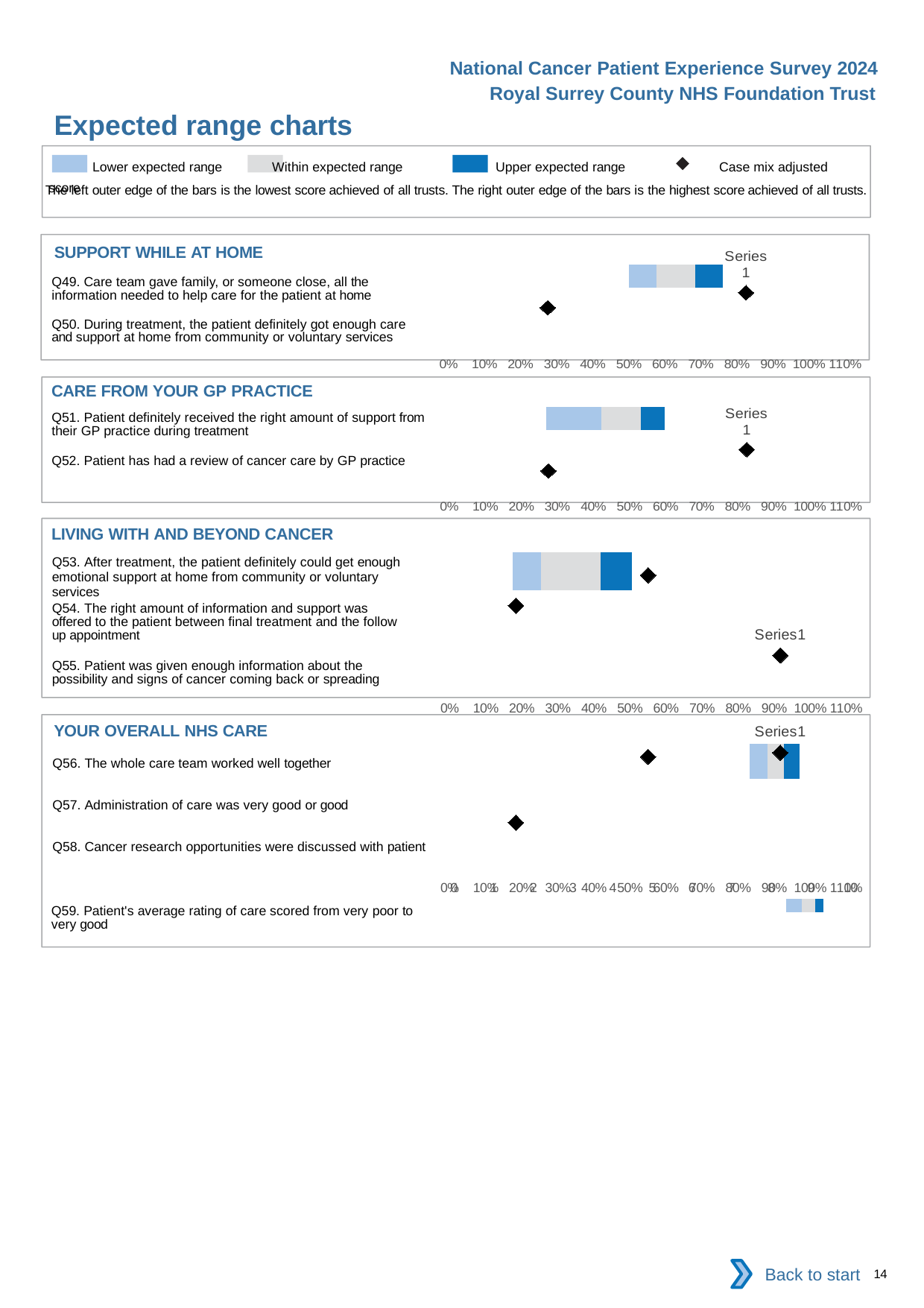
In the SUPPORT WHILE AT HOME chart, which has the higher case mix adjusted score, Q49 or Q50? Q49 What is the title of the slide's charts? Expected range charts In the SUPPORT WHILE AT HOME chart, is the case mix adjusted score for Q49 greater or less than 70%? greater How many questions are plotted in the LIVING WITH AND BEYOND CANCER chart? 3 What is the highest value shown on the x axis of the CARE FROM YOUR GP PRACTICE chart? 110% What kind of chart is used in the SUPPORT WHILE AT HOME section? bar chart How many entries does the legend at the top of the slide list? 4 In the CARE FROM YOUR GP PRACTICE chart, which has the higher case mix adjusted score, Q51 or Q52? Q51 In the LIVING WITH AND BEYOND CANCER chart, is the case mix adjusted score for Q54 greater or less than 30%? less In the CARE FROM YOUR GP PRACTICE chart, is the case mix adjusted score for Q52 greater or less than 40%? less What does the black diamond marker represent according to the legend? Case mix adjusted score